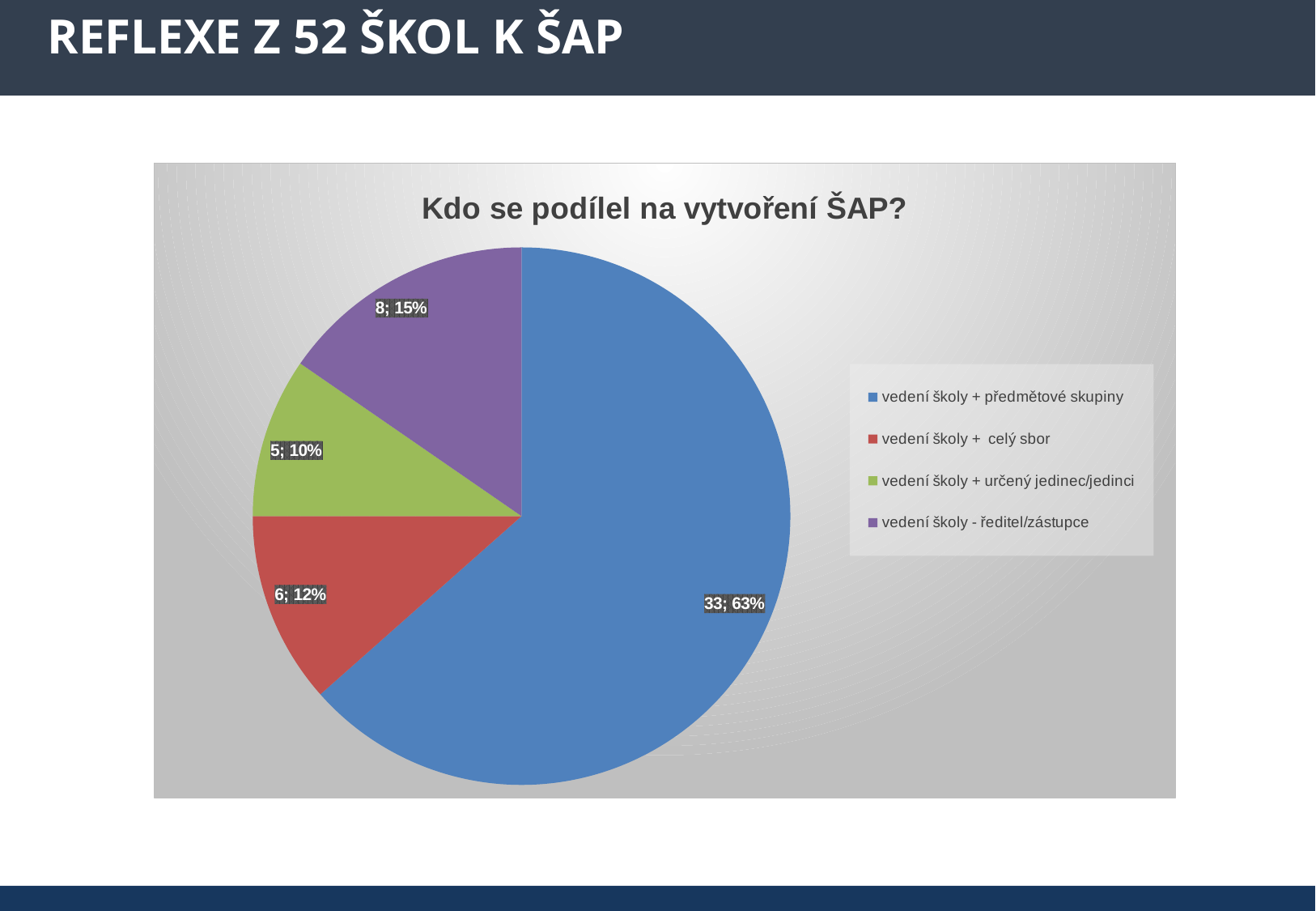
Which category has the smallest slice? vedení školy + určený jedinec/jedinci What count is shown for 'vedení školy + celý sbor'? 6 What count is shown for 'vedení školy + předmětové skupiny'? 33 What percentage share is shown for 'vedení školy + předmětové skupiny'? 63% How many slices does the pie chart have? 4 What count is shown for 'vedení školy - ředitel/zástupce'? 8 What is the difference in count between 'vedení školy + předmětové skupiny' and 'vedení školy - ředitel/zástupce'? 25 Which category has the largest slice? vedení školy + předmětové skupiny What percentage share is shown for 'vedení školy + určený jedinec/jedinci'? 10% How many entries does the legend list? 4 What is the title of the chart? Kdo se podílel na vytvoření ŠAP? What kind of chart is shown on the slide? pie chart